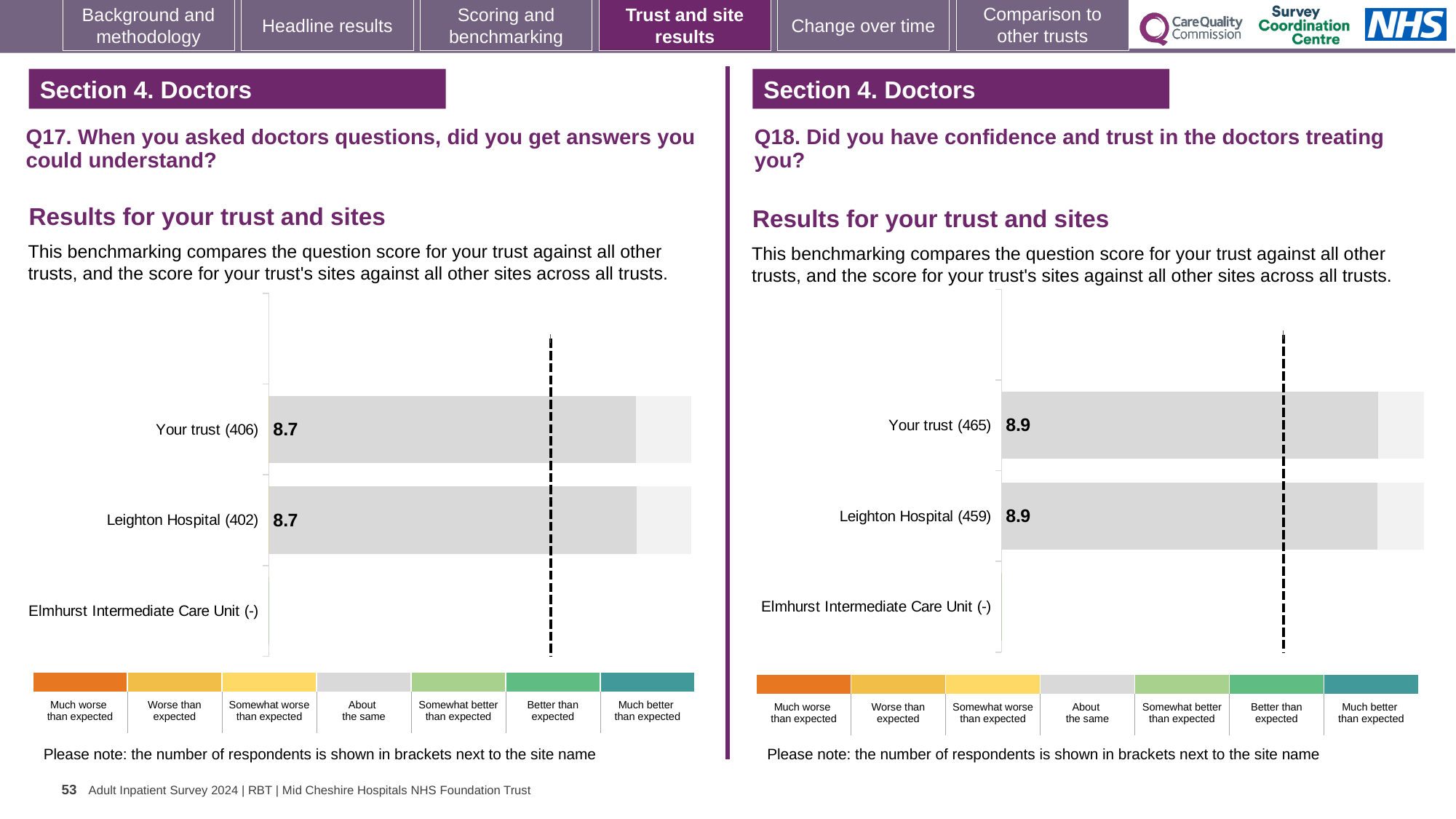
On the Q17 chart (left), which category has no score shown? Elmhurst Intermediate Care Unit (-) What is the difference between the Your trust score on the Q18 chart (right) and the Your trust score on the Q17 chart (left)? 0.2 On the Q17 chart (left), how many respondents are shown in brackets for Your trust? 406 On the Q18 chart (right), what is the score for Your trust? 8.9 How many sites or categories are listed on the Q17 chart (left)? 3 On the Q18 chart (right), what is the score for Leighton Hospital? 8.9 How many benchmark categories does the colour key below the Q18 chart (right) list? 7 Is the score for Your trust higher on the Q17 chart (left) or the Q18 chart (right)? Q18 chart (right) On the Q17 chart (left), what is the score for Your trust? 8.7 On the Q18 chart (right), how many respondents are shown in brackets for Leighton Hospital? 459 What kind of chart is the Q18 chart (right)? Bar chart On the Q17 chart (left), what is the score for Leighton Hospital? 8.7